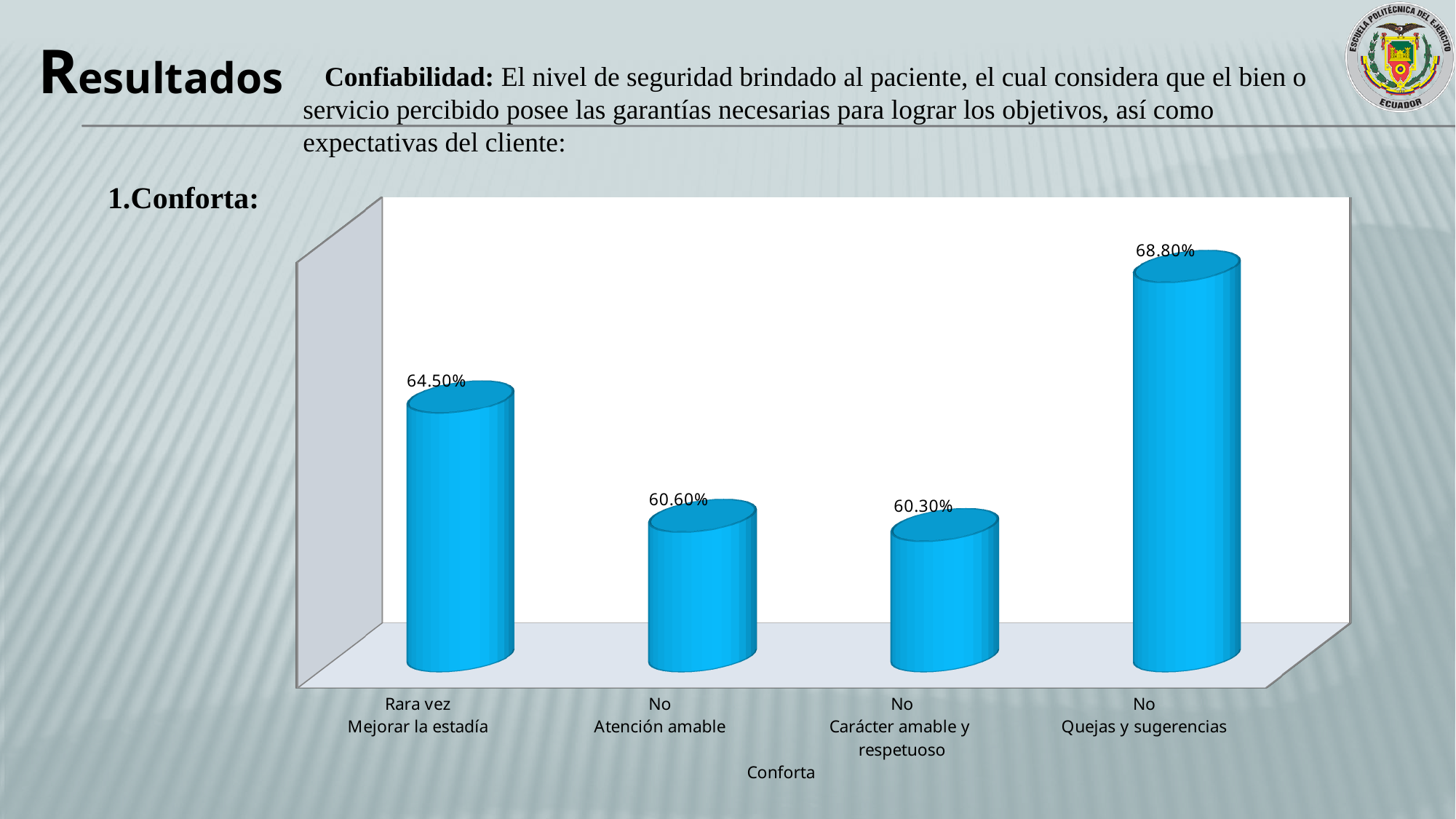
Which category has the highest value? Quejas y sugerencias What is the difference between the values for 'Atención amable' and 'Carácter amable y respetuoso'? 0.30% What is the value for 'Quejas y sugerencias' (No)? 68.80% What kind of chart is shown on the slide? Bar chart What is the value for 'Carácter amable y respetuoso' (No)? 60.30% What is the value for 'Atención amable' (No)? 60.60% What is the value for 'Mejorar la estadía' (Rara vez)? 64.50% What is the x-axis title of the chart? Conforta Which is larger, the value for 'Mejorar la estadía' or the value for 'Atención amable'? Mejorar la estadía How many categories are shown in the chart? 4 Which category has the lowest value? Carácter amable y respetuoso What is the difference between the values for 'Quejas y sugerencias' and 'Mejorar la estadía'? 4.30%